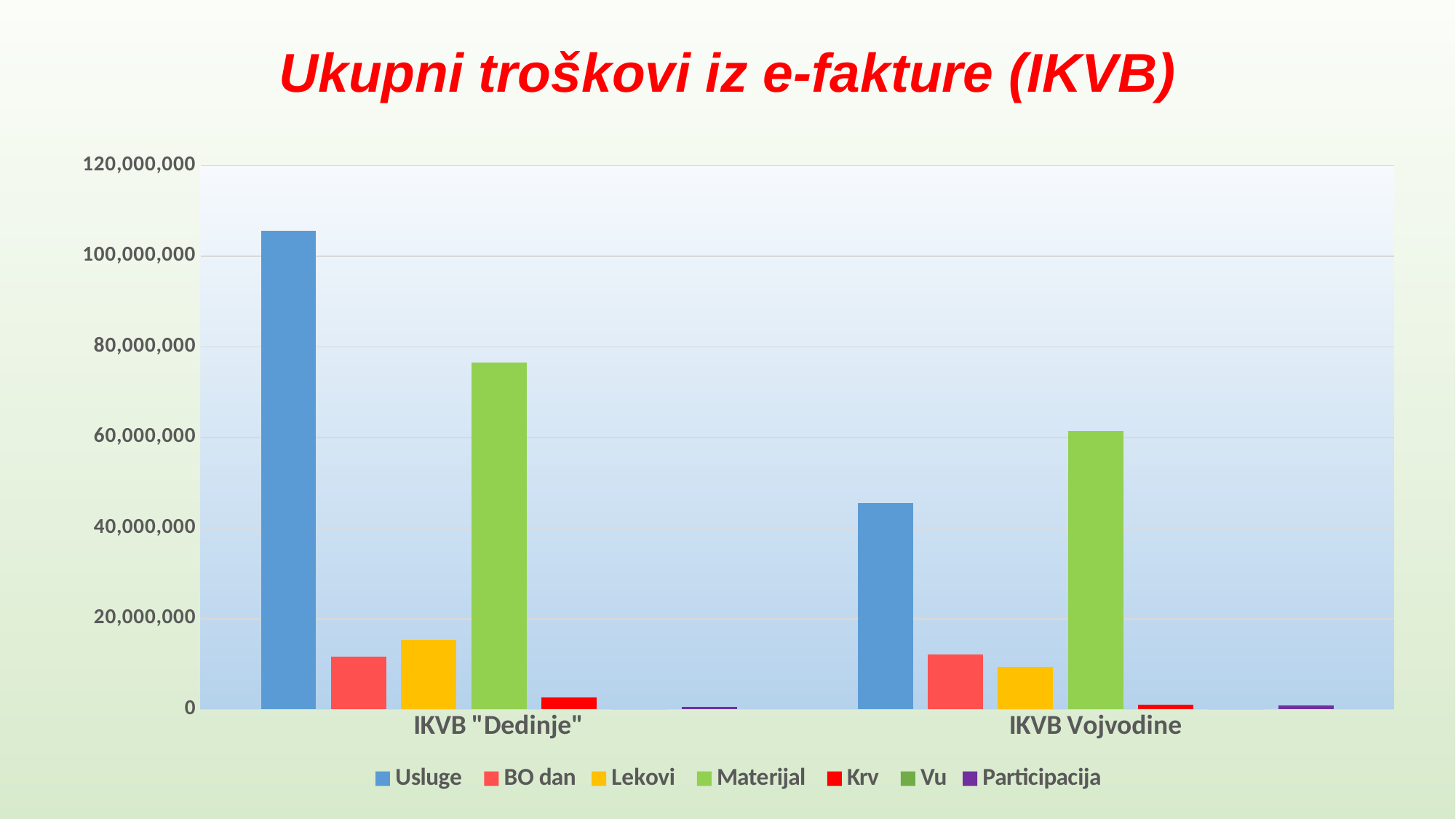
How many categories are shown on the x axis? 2 Which category has the larger Usluge value, IKVB "Dedinje" or IKVB Vojvodine? IKVB "Dedinje" How many series does the legend list? 7 Which category has the larger Materijal value, IKVB "Dedinje" or IKVB Vojvodine? IKVB "Dedinje" Which series has the highest value for IKVB "Dedinje"? Usluge Which series has the highest value for IKVB Vojvodine? Materijal For IKVB "Dedinje", which is larger, Lekovi or BO dan? Lekovi Is the value of Usluge for IKVB Vojvodine greater or less than 60,000,000? less Is the value of Materijal for IKVB Vojvodine greater or less than 40,000,000? greater What is the title of the chart? Ukupni troškovi iz e-fakture (IKVB) Is the value of Usluge for IKVB "Dedinje" greater or less than 100,000,000? greater What kind of chart is shown on the slide? Bar chart